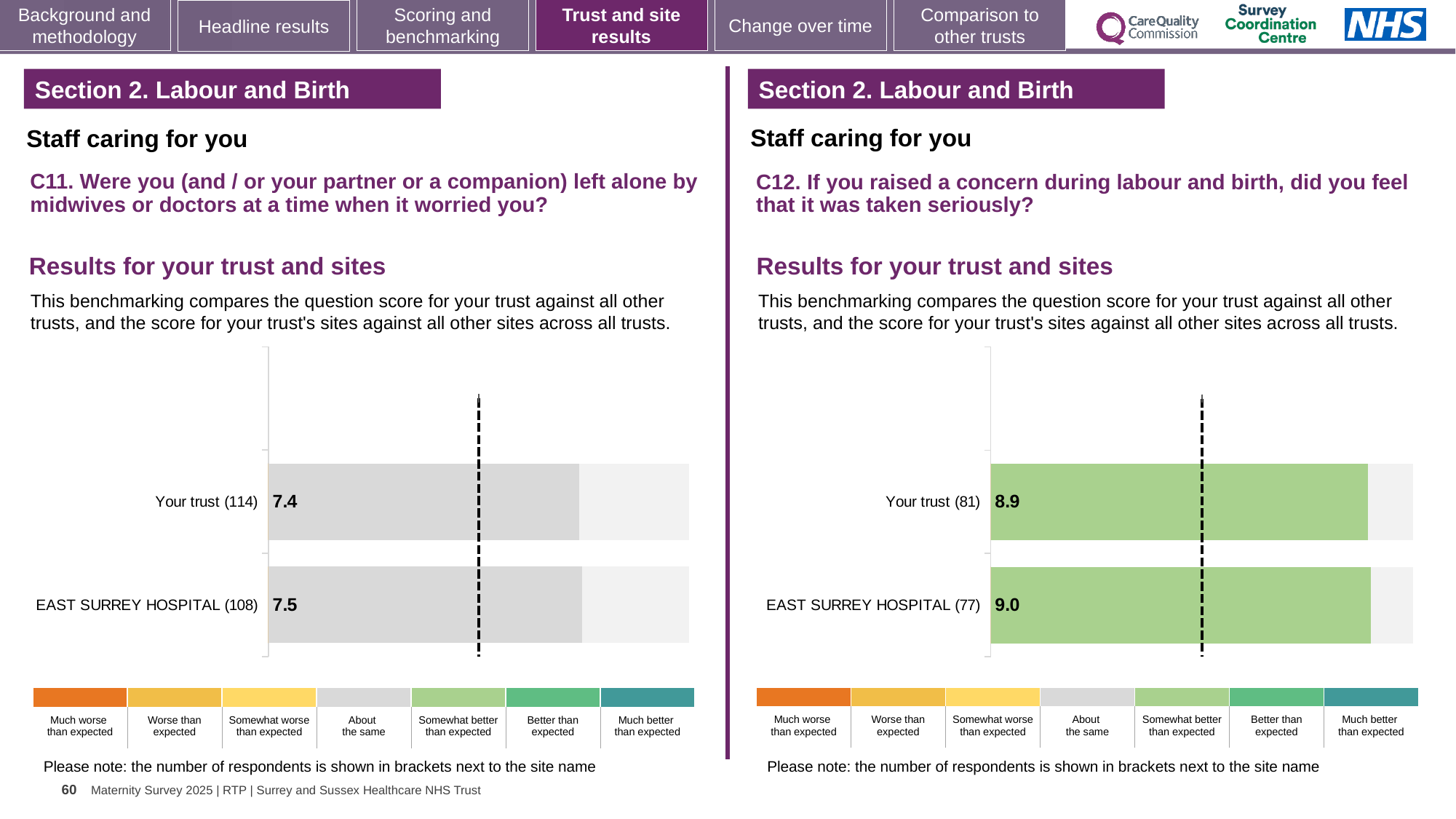
In the C11 chart on the left, what is the difference between the EAST SURREY HOSPITAL score and the Your trust score? 0.1 In the C12 chart on the right, what is the score for EAST SURREY HOSPITAL? 9.0 In the C12 chart on the right, what is the difference between the EAST SURREY HOSPITAL score and the Your trust score? 0.1 What kind of chart is used in the C12 chart on the right? Bar chart In the C11 chart on the left, how many respondents are shown in brackets for EAST SURREY HOSPITAL? 108 In the C11 chart on the left, what is the score for EAST SURREY HOSPITAL? 7.5 In the C11 chart on the left, what is the score for Your trust? 7.4 In the C11 chart on the left, how many bars are plotted? 2 In the C12 chart on the right, what is the score for Your trust? 8.9 In the C12 chart on the right, how many respondents are shown in brackets for Your trust? 81 In the C12 chart on the right, which benchmark category does the colour of the bars correspond to according to the legend? Somewhat better than expected In the C11 chart on the left, which benchmark category does the colour of the bars correspond to according to the legend? About the same